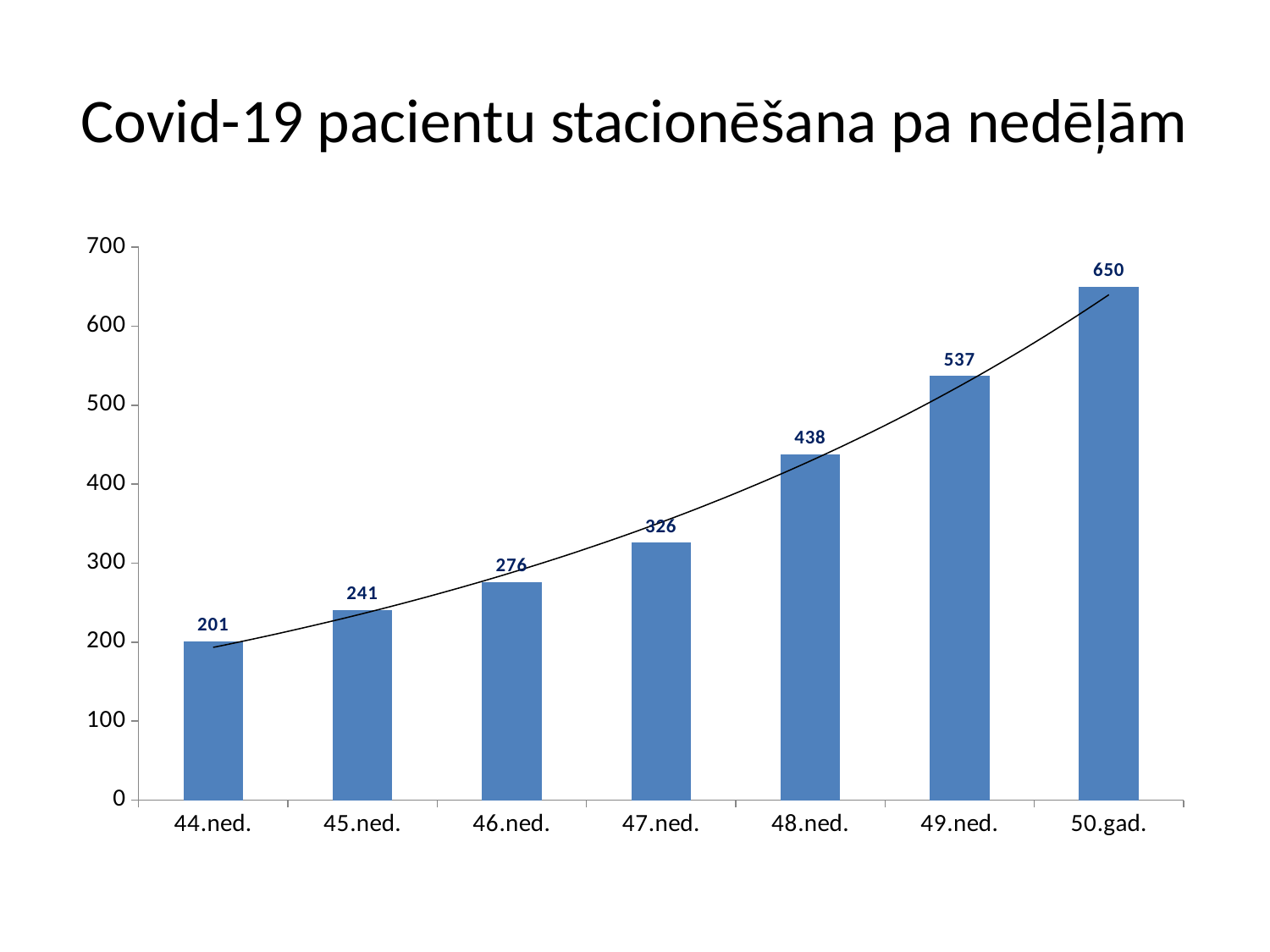
What kind of chart is shown on the slide? bar chart What is the value for 49.ned.? 537 Do the values rise or fall from 44.ned. to 50.gad.? rise Which category has the highest value? 50.gad. Is the value for 48.ned. greater or less than 400? greater What is the difference between the values for 50.gad. and 49.ned.? 113 How many categories are shown on the x axis? 7 Which category has the lowest value? 44.ned. What is the value for 44.ned.? 201 What is the difference between the values for 46.ned. and 45.ned.? 35 Which is larger, the value for 48.ned. or the value for 47.ned.? 48.ned. What is the value for 47.ned.? 326